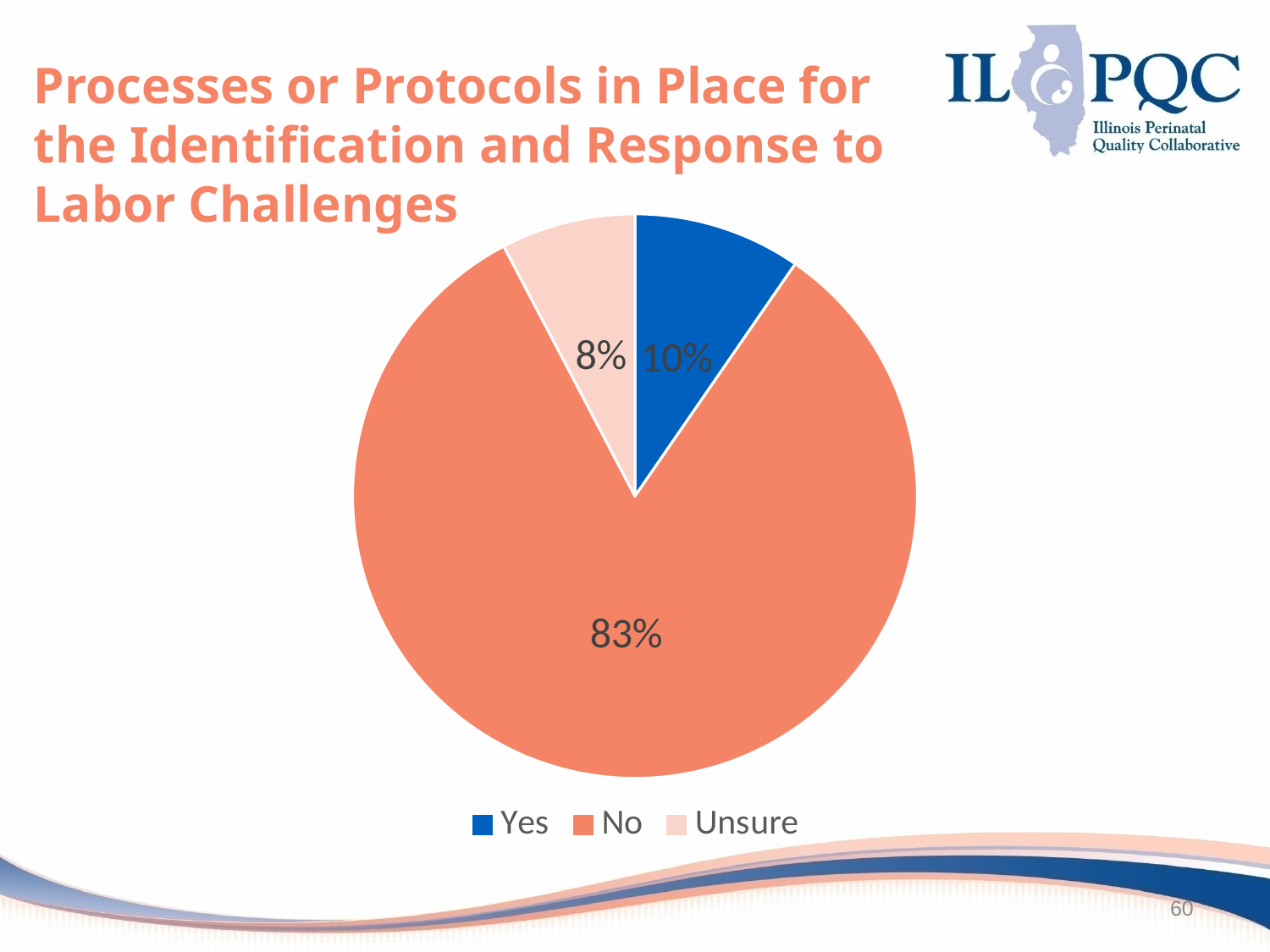
What is the difference in percentage points between the "No" slice and the "Yes" slice? 73 What percentage of the pie is labelled "Unsure"? 8% What type of chart is shown on the slide? pie chart What percentage of the pie is labelled "Yes"? 10% What is the title of the chart on the slide? Processes or Protocols in Place for the Identification and Response to Labor Challenges What colour is the "No" slice of the pie? orange What is the combined percentage of the "Yes" and "Unsure" slices? 18% How many categories does the legend list? 3 Which is larger, the "Yes" slice or the "Unsure" slice? Yes Which category has the smallest slice of the pie? Unsure Which category has the largest slice of the pie? No What percentage of the pie is labelled "No"? 83%